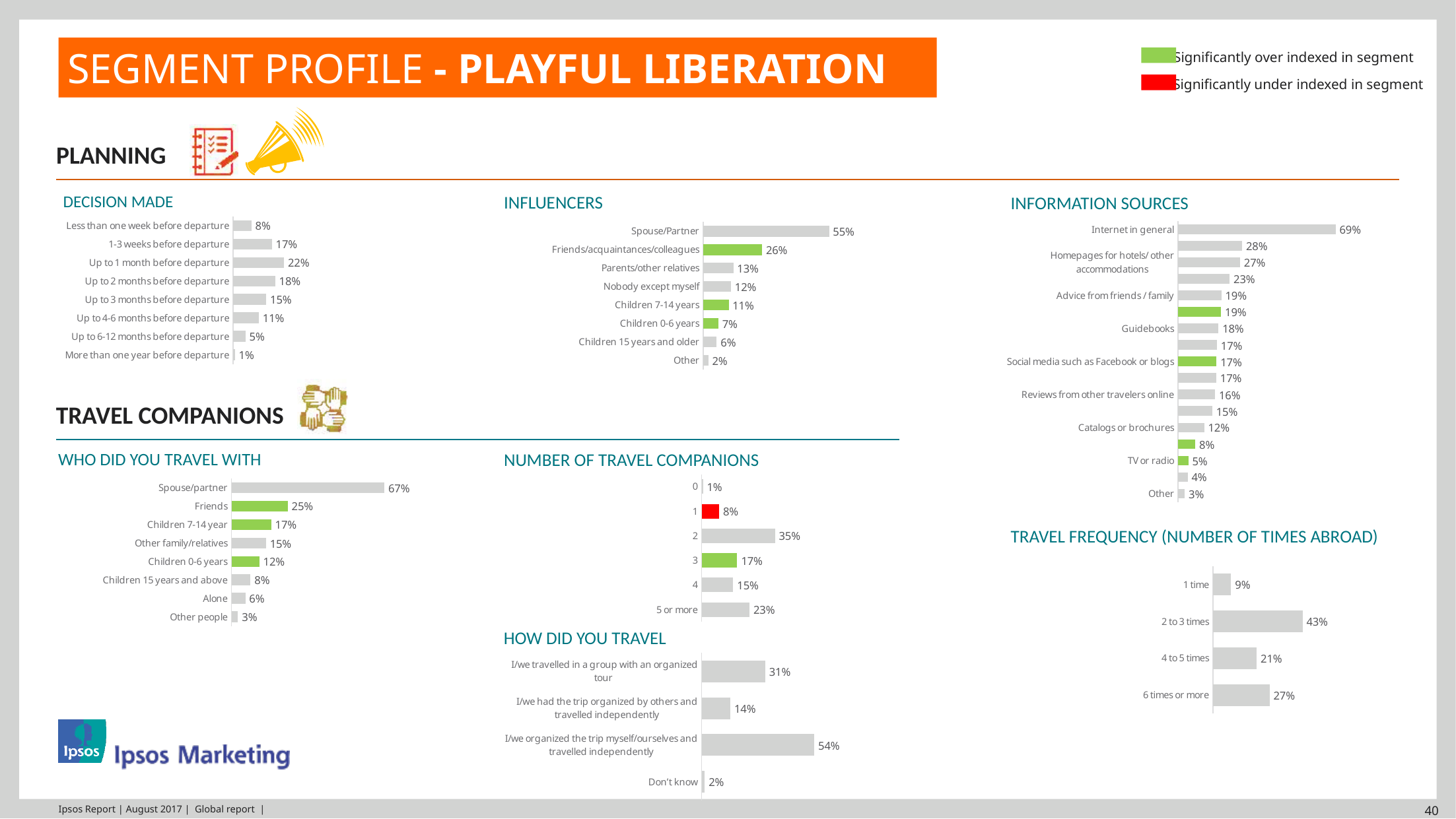
In the DECISION MADE chart, what is the value for 'Up to 1 month before departure'? 22% In the INFORMATION SOURCES chart, what is the value for 'Internet in general'? 69% In the NUMBER OF TRAVEL COMPANIONS chart, what is the value for '2'? 35% In the HOW DID YOU TRAVEL chart, which is larger: 'I/we travelled in a group with an organized tour' or 'I/we had the trip organized by others and travelled independently'? I/we travelled in a group with an organized tour In the NUMBER OF TRAVEL COMPANIONS chart, which bar is coloured red? 1 In the TRAVEL FREQUENCY (NUMBER OF TIMES ABROAD) chart, what is the value for '6 times or more'? 27% In the DECISION MADE chart, which category has the lowest value? More than one year before departure In the INFLUENCERS chart, what is the value for 'Friends/acquaintances/colleagues'? 26% In the WHO DID YOU TRAVEL WITH chart, how many categories are shown? 8 In the INFLUENCERS chart, what is the difference between 'Spouse/Partner' and 'Parents/other relatives'? 42% What type of chart is the TRAVEL FREQUENCY (NUMBER OF TIMES ABROAD) chart? Bar chart In the WHO DID YOU TRAVEL WITH chart, which category has the highest value? Spouse/partner